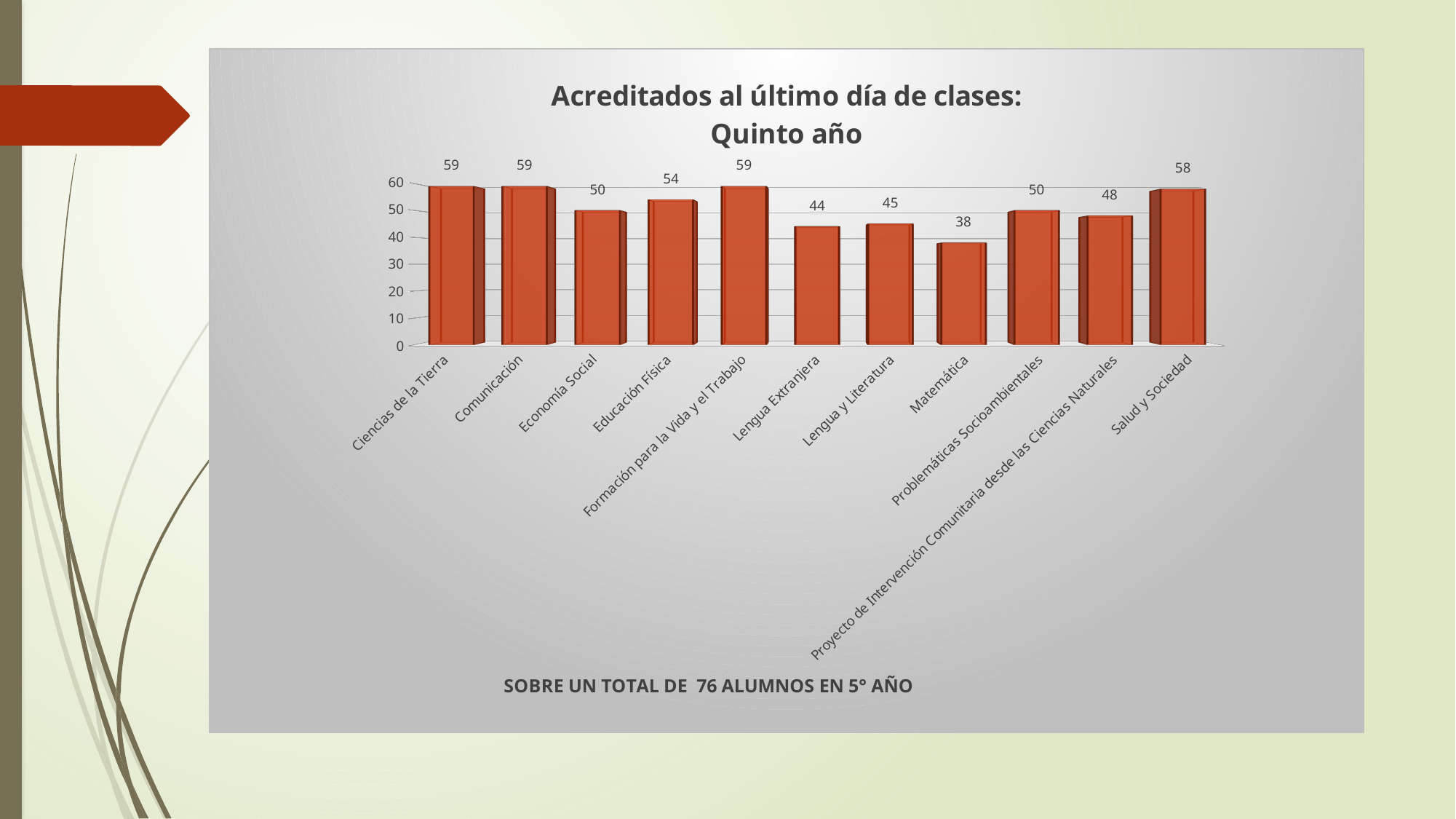
Which category has the lowest value? Matemática What is the value for Lengua Extranjera? 44 What is the value for Salud y Sociedad? 58 How many categories are shown on the x axis? 11 What is the value for Matemática? 38 What is the value for Educación Física? 54 Which is larger, the value for Lengua y Literatura or the value for Economía Social? Economía Social What is the difference between the values for Salud y Sociedad and Proyecto de Intervención Comunitaria desde las Ciencias Naturales? 10 What is the difference between the values for Comunicación and Matemática? 21 Is the value for Matemática greater or less than 40? less What kind of chart is shown on the slide? bar chart What is the title of the chart? Acreditados al último día de clases: Quinto año